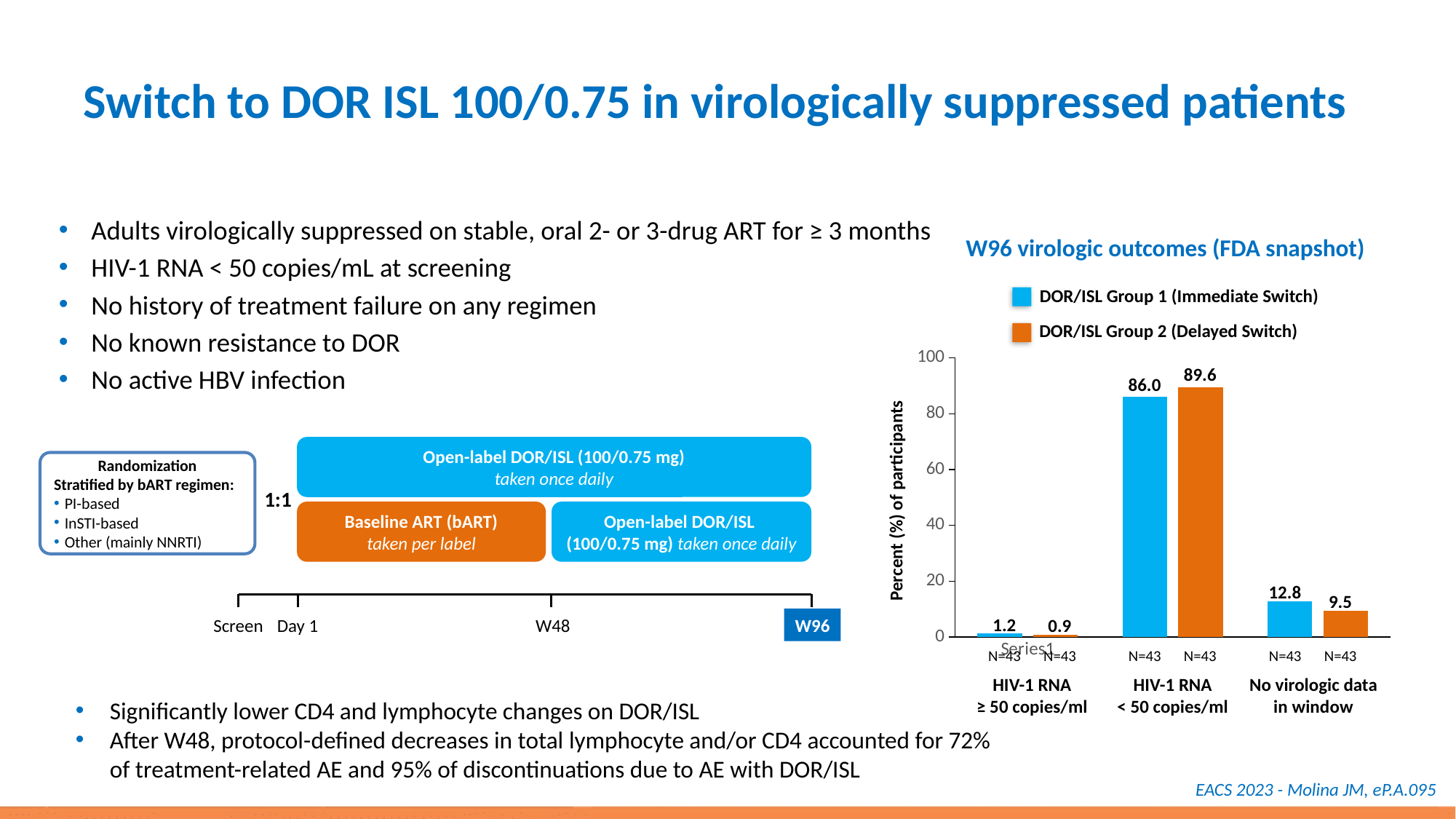
Which group has the larger value for no virologic data in window? DOR/ISL Group 1 (Immediate Switch) How many outcome categories are shown on the x axis of the chart? 3 What percentage of participants in DOR/ISL Group 1 (Immediate Switch) had HIV-1 RNA ≥ 50 copies/ml? 1.2 What percentage of participants in DOR/ISL Group 2 (Delayed Switch) had no virologic data in window? 9.5 What percentage of participants in DOR/ISL Group 1 (Immediate Switch) had HIV-1 RNA < 50 copies/ml at W96? 86.0 Which outcome category has the lowest value for DOR/ISL Group 2 (Delayed Switch)? HIV-1 RNA ≥ 50 copies/ml Which outcome category has the highest value for DOR/ISL Group 1 (Immediate Switch)? HIV-1 RNA < 50 copies/ml What is the difference between Group 2 and Group 1 for HIV-1 RNA < 50 copies/ml? 3.6 What percentage of participants in DOR/ISL Group 2 (Delayed Switch) had HIV-1 RNA < 50 copies/ml at W96? 89.6 How many series does the chart legend list? 2 What type of chart is used to show the W96 virologic outcomes? Bar chart Is the value for DOR/ISL Group 1 with HIV-1 RNA < 50 copies/ml greater or less than 80? greater